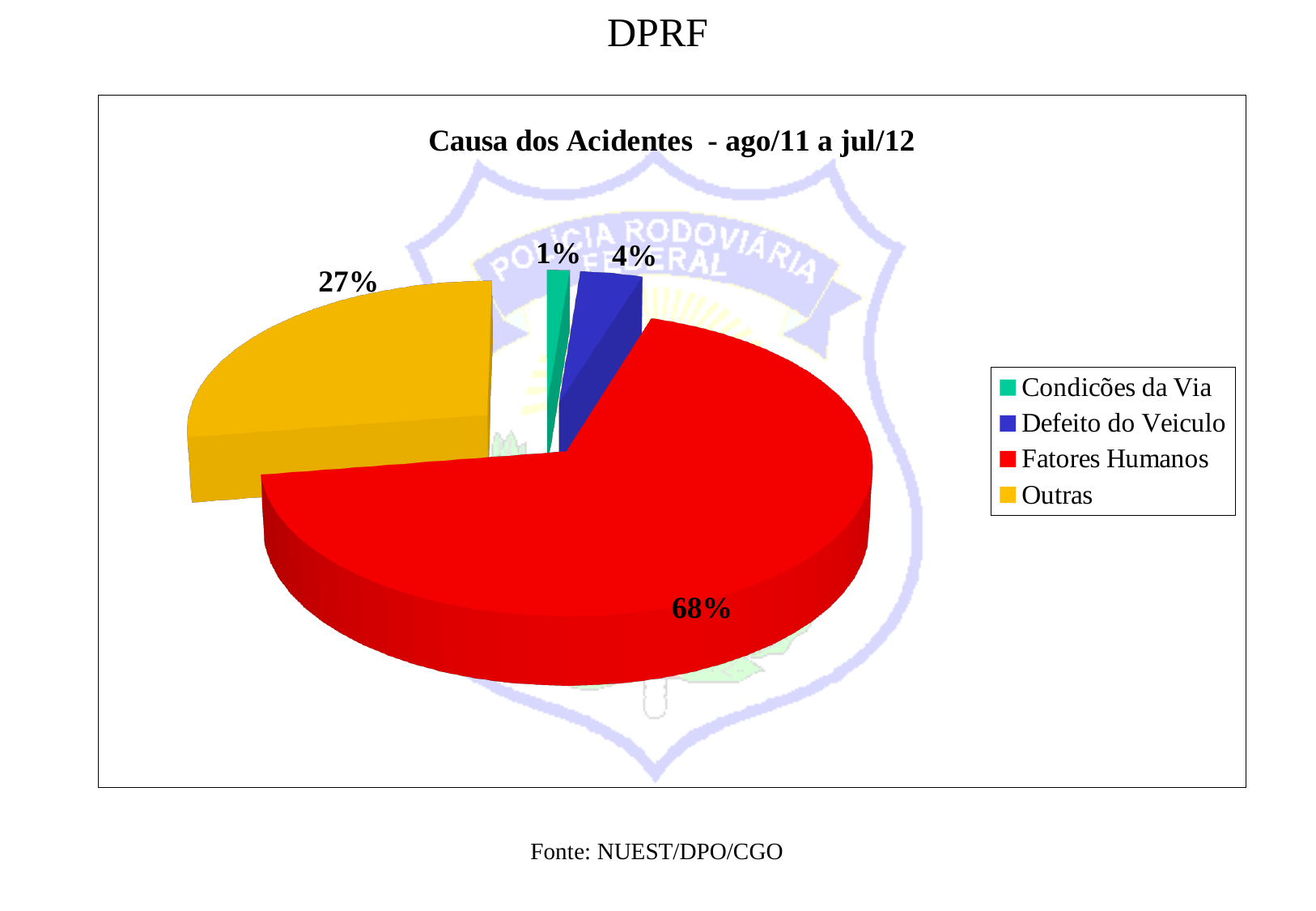
Which category has the smallest slice of the pie? Condicões da Via What share of the pie does Condicões da Via account for? 1% Which category has the largest slice of the pie? Fatores Humanos What share of the pie does Fatores Humanos account for? 68% What is the title of the chart? Causa dos Acidentes - ago/11 a jul/12 What share of the pie does Defeito do Veiculo account for? 4% What is the difference in percentage points between Fatores Humanos and Outras? 41 How many categories are shown in the pie chart? 4 What kind of chart is shown on the slide? Pie chart What colour is the slice for Fatores Humanos? Red Which is larger, the slice for Outras or the slice for Defeito do Veiculo? Outras